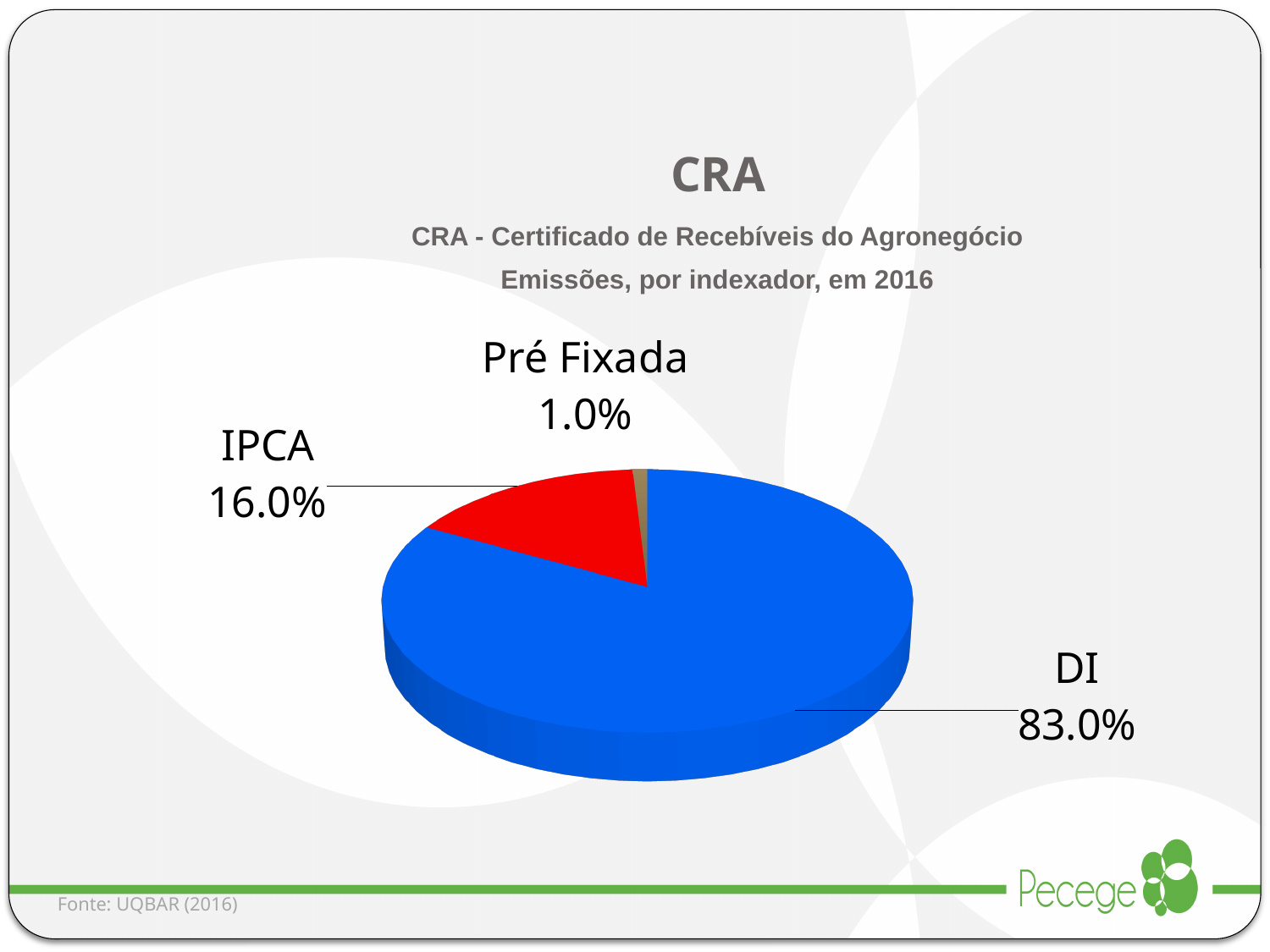
Which indexer has the largest share of CRA emissions in 2016? DI What kind of chart is shown on the slide? Pie chart What share of CRA emissions in 2016 is indexed to DI? 83.0% What share of CRA emissions in 2016 is indexed to IPCA? 16.0% What is the combined share of IPCA and Pré Fixada? 17.0% What is the source cited for the chart? UQBAR (2016) What is the difference in percentage points between the DI share and the IPCA share? 67.0 percentage points Which indexer has the smallest share of CRA emissions in 2016? Pré Fixada What share of CRA emissions in 2016 is Pré Fixada? 1.0% Which has a larger share, IPCA or Pré Fixada? IPCA What colour is the DI slice of the pie chart? Blue How many indexer categories are shown in the pie chart? 3